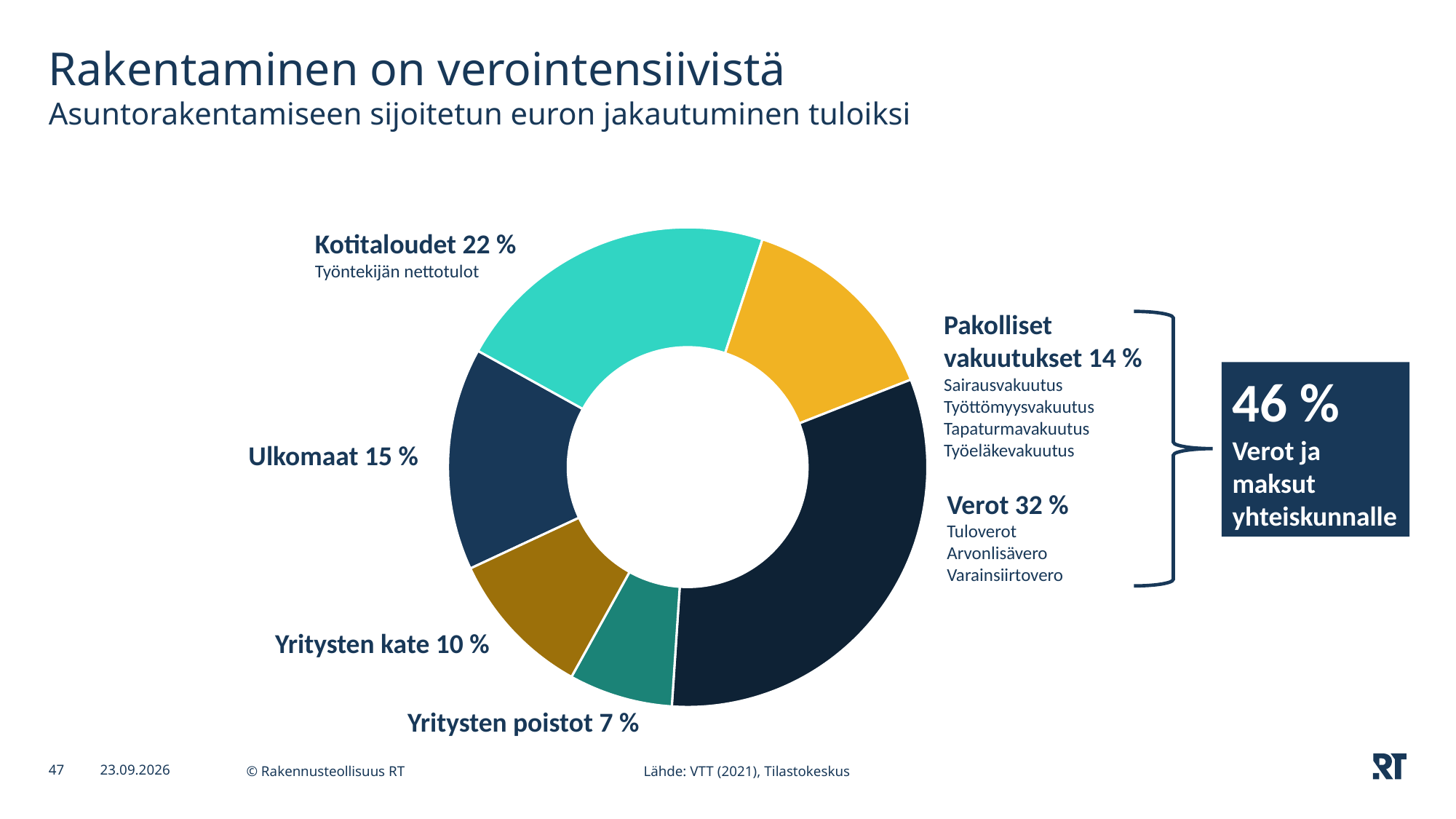
Which is larger, the share for Ulkomaat or the share for Pakolliset vakuutukset? Ulkomaat What share of the invested euro goes to Yritysten poistot? 7 % What is the difference in percentage points between Verot and Kotitaloudet? 10 What is the subtitle of the chart on the slide? Asuntorakentamiseen sijoitetun euron jakautuminen tuloiksi What is the combined share of Pakolliset vakuutukset and Verot, as shown in the callout box? 46 % Which category has the largest share of the donut chart? Verot Which category has the smallest share of the donut chart? Yritysten poistot What kind of chart is shown on the slide? Donut (pie) chart How many slices does the donut chart have? 6 What share of the invested euro goes to Verot? 32 % What share of the invested euro goes to Ulkomaat? 15 % What share of the invested euro goes to Kotitaloudet? 22 %